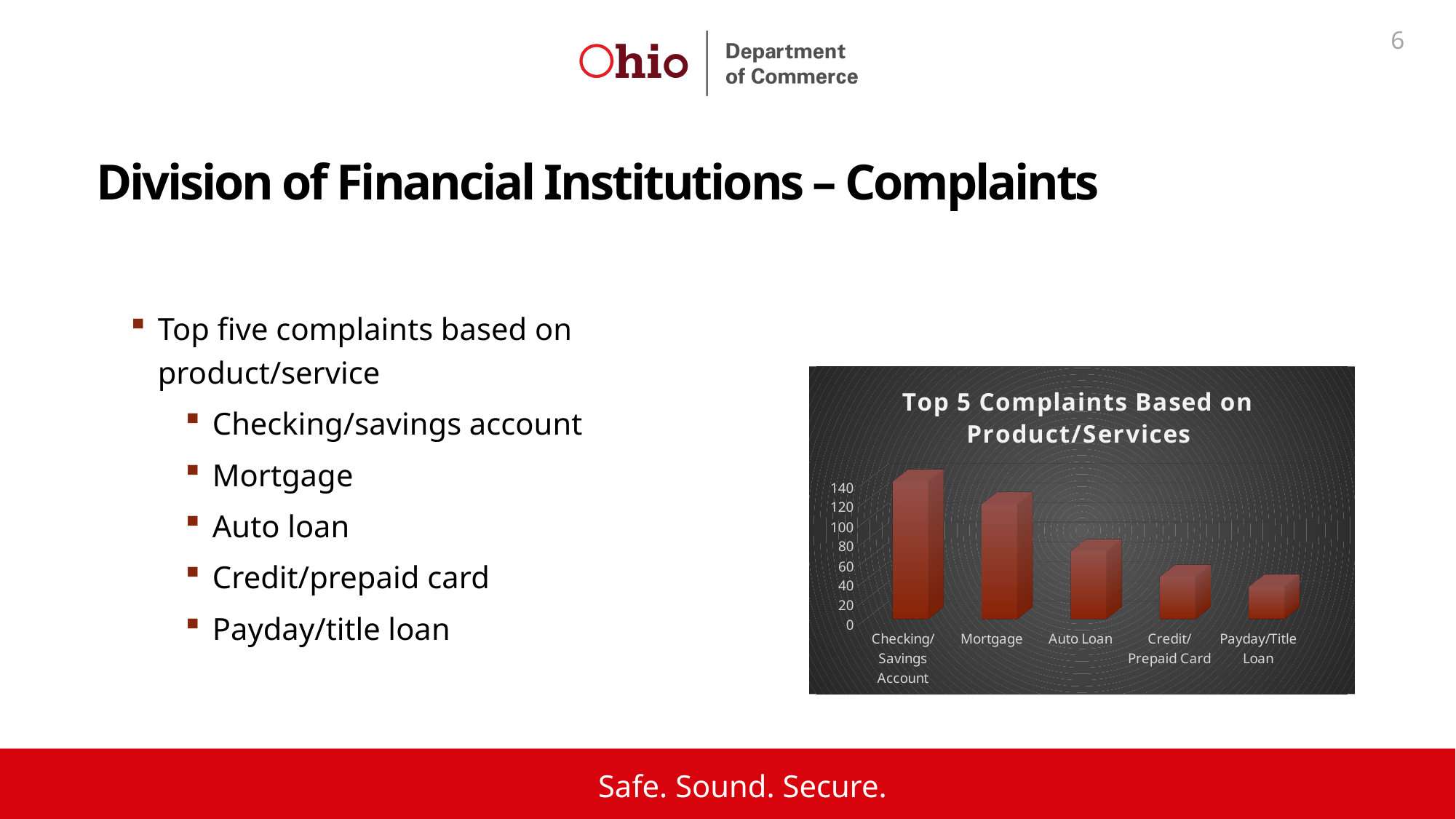
How many categories are plotted in the chart? 5 What is the title of the chart? Top 5 Complaints Based on Product/Services Do the values rise or fall moving from left to right along the x axis? fall Is the value for Payday/Title Loan greater or less than 60? less Which category has the highest value in the chart? Checking/Savings Account Is the value for Auto Loan greater or less than 100? less What kind of chart is shown on the slide? bar chart Is the value for Checking/Savings Account greater or less than 120? greater Which category has the lowest value in the chart? Payday/Title Loan Which is larger, the value for Mortgage or the value for Auto Loan? Mortgage Which is larger, the value for Credit/Prepaid Card or the value for Checking/Savings Account? Checking/Savings Account